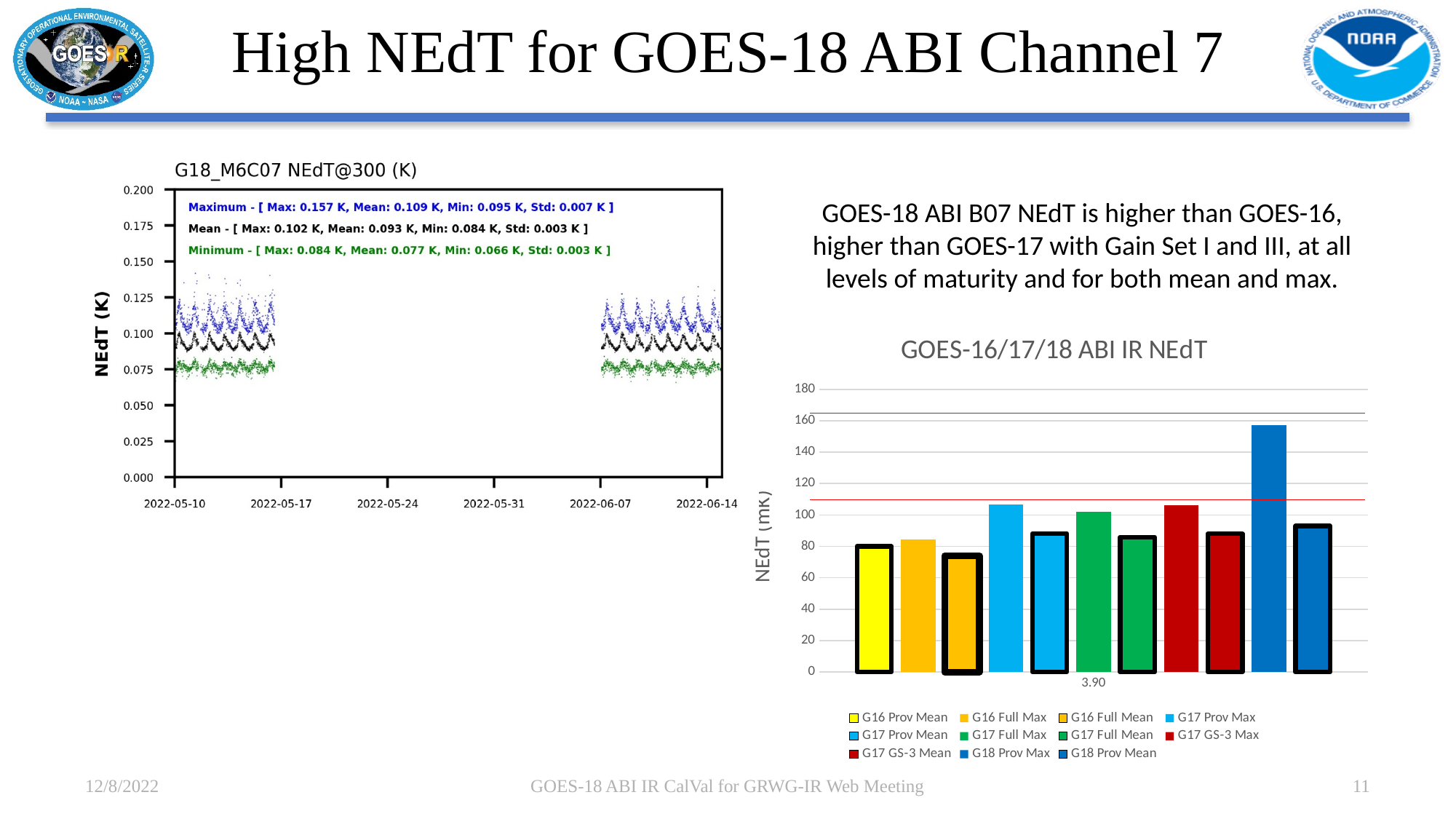
In the bar chart titled 'GOES-16/17/18 ABI IR NEdT', is the value for G16 Full Mean greater or less than 100? less What is the y-axis label of the bar chart titled 'GOES-16/17/18 ABI IR NEdT'? NEdT (mK) In the bar chart titled 'GOES-16/17/18 ABI IR NEdT', is the value for G18 Prov Max greater or less than 140? greater In the bar chart titled 'GOES-16/17/18 ABI IR NEdT', which series has the highest bar? G18 Prov Max In the chart titled 'G18_M6C07 NEdT@300 (K)', what is the Std value reported for the Maximum series? 0.007 K In the bar chart titled 'GOES-16/17/18 ABI IR NEdT', which is larger, G18 Prov Max or G17 Prov Max? G18 Prov Max In the bar chart titled 'GOES-16/17/18 ABI IR NEdT', is the value for G17 Prov Max greater or less than 100? greater What kind of chart is the chart titled 'GOES-16/17/18 ABI IR NEdT'? bar chart How many series does the legend of the bar chart titled 'GOES-16/17/18 ABI IR NEdT' list? 11 In the chart titled 'G18_M6C07 NEdT@300 (K)', what is the Mean value reported for the Mean series? 0.093 K In the chart titled 'G18_M6C07 NEdT@300 (K)', what is the Max value reported for the Maximum series? 0.157 K In the chart titled 'G18_M6C07 NEdT@300 (K)', what is the Min value reported for the Minimum series? 0.066 K